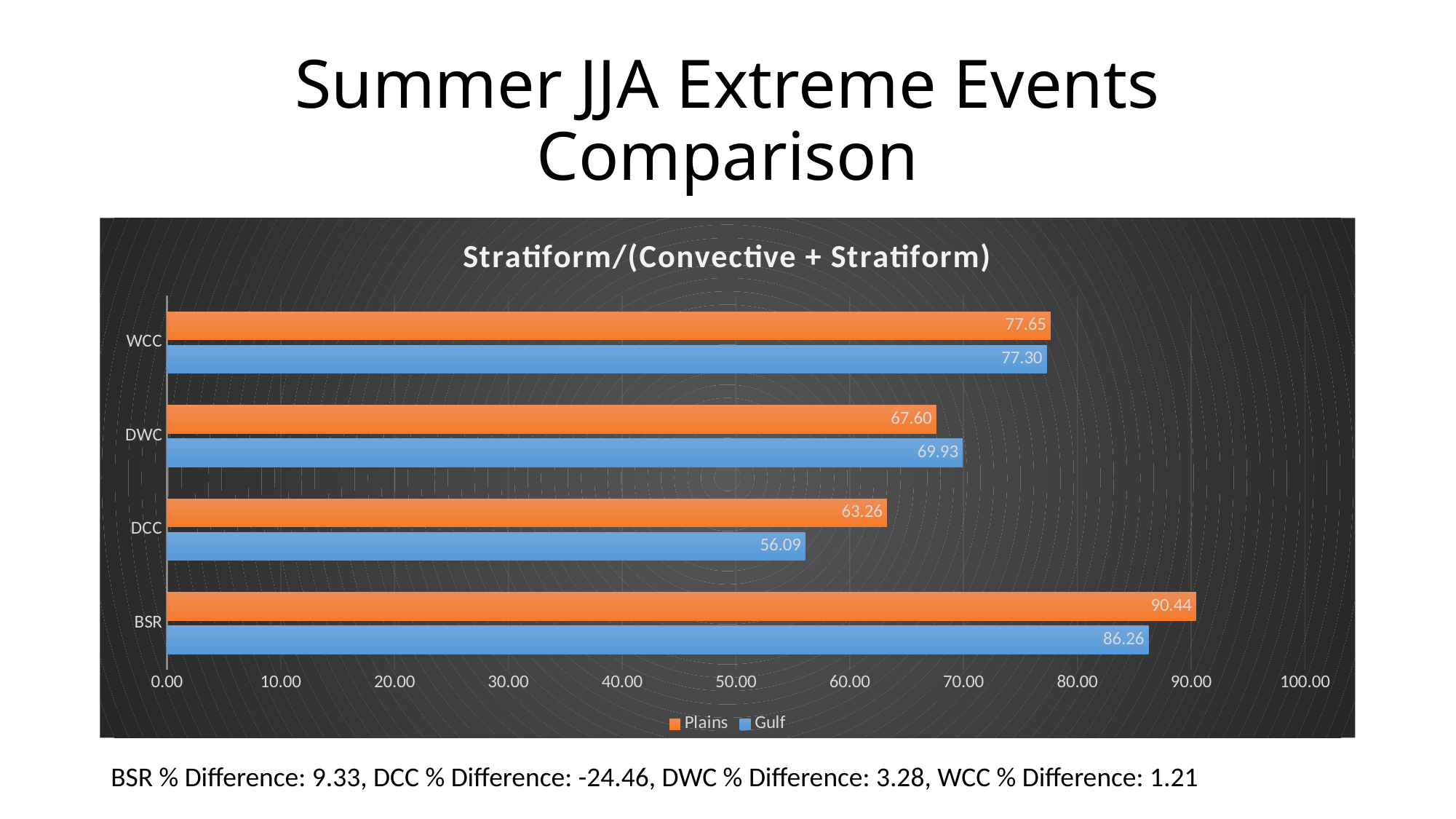
For DCC, which is larger, the Plains value or the Gulf value? Plains Which category has the lowest Gulf value? DCC Which category has the highest Plains value? BSR What kind of chart is shown on the slide? Bar chart What is the Plains value for WCC? 77.65 How many series does the legend list? 2 What is the Gulf value for DCC? 56.09 How many categories are shown on the chart? 4 What is the difference between the Plains and Gulf values for BSR? 4.18 What is the Gulf value for DWC? 69.93 For DWC, which is larger, the Plains value or the Gulf value? Gulf What is the title of the chart? Stratiform/(Convective + Stratiform)